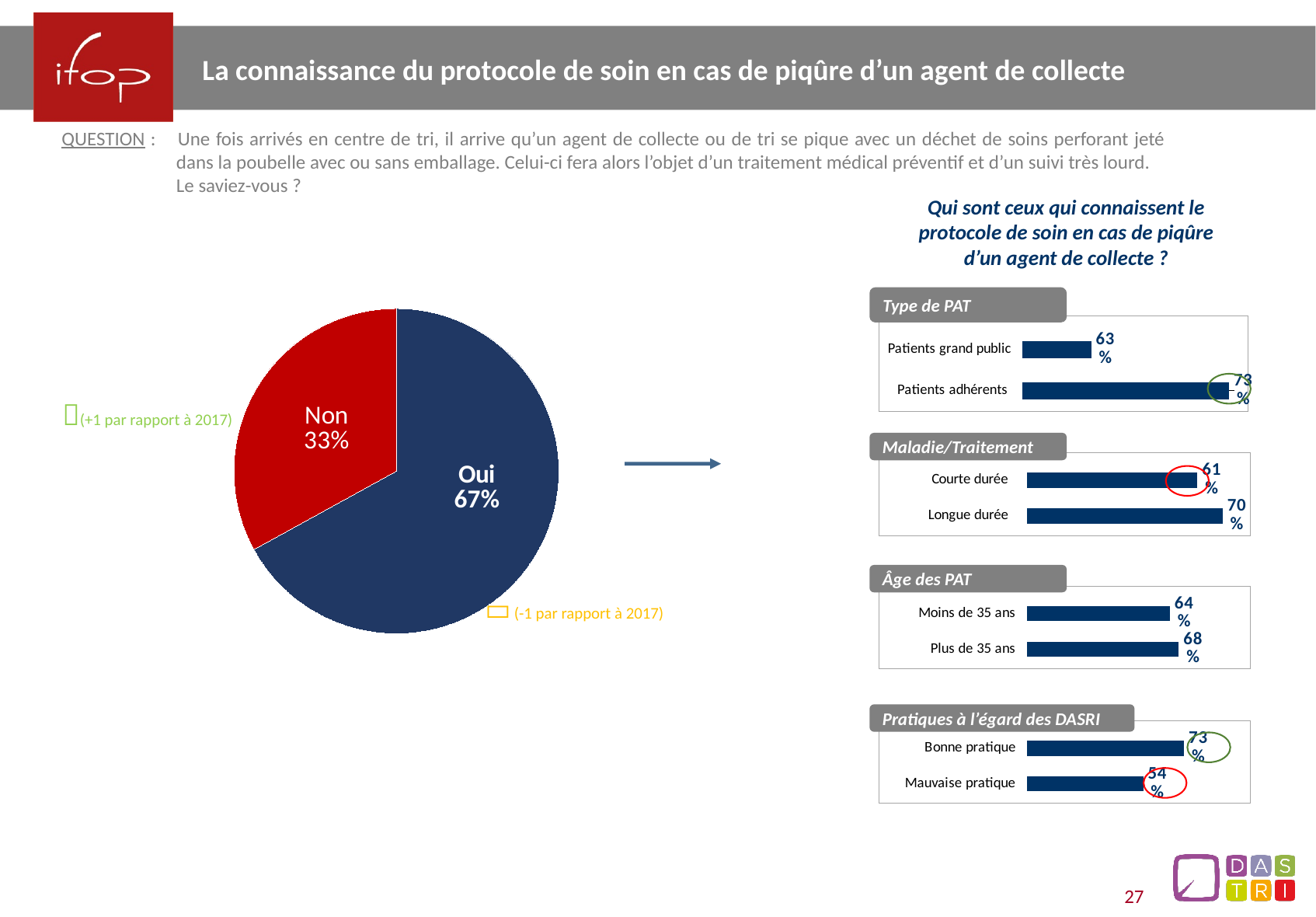
In the "Âge des PAT" bar chart, which is larger, Moins de 35 ans or Plus de 35 ans? Plus de 35 ans In the "Pratiques à l'égard des DASRI" bar chart, what is the difference between Bonne pratique and Mauvaise pratique? 19 points In the pie chart, what share of respondents answered "Oui"? 67% In the "Type de PAT" bar chart, what is the value for Patients adhérents? 73% In the "Maladie/Traitement" bar chart, which category has the higher value? Longue durée What kind of chart is the large chart on the left of the slide? Pie chart How many slices does the pie chart have? 2 In the "Type de PAT" bar chart, what is the difference between Patients adhérents and Patients grand public? 10 points In the "Pratiques à l'égard des DASRI" bar chart, what is the value for Mauvaise pratique? 54% In the "Maladie/Traitement" bar chart, what is the value for Courte durée? 61% In the pie chart, what share of respondents answered "Non"? 33% In the "Âge des PAT" bar chart, what is the value for Plus de 35 ans? 68%